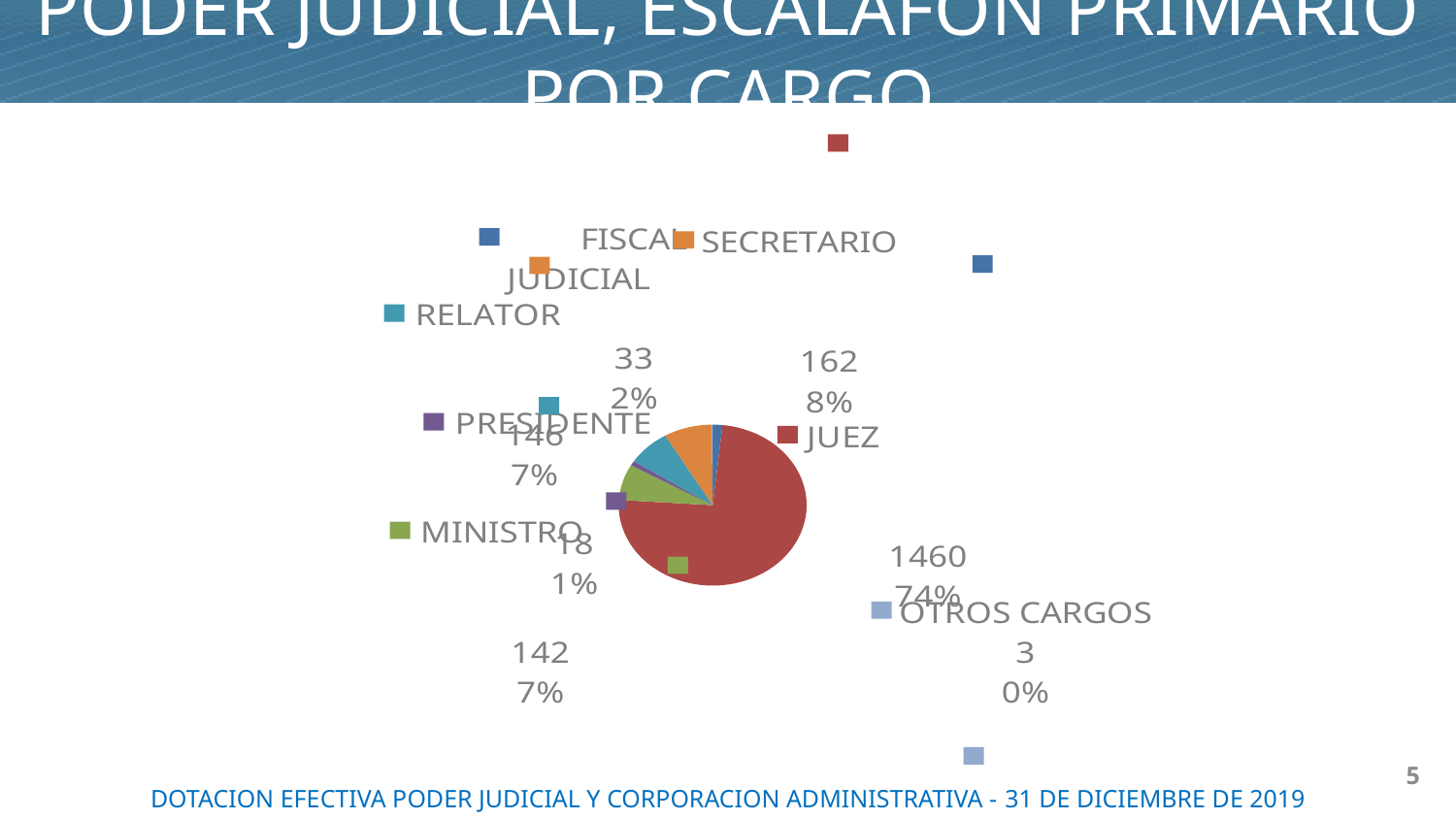
What percentage is shown for the smallest slice of the pie chart? 0% What is the difference between the largest value (1460) and the smallest value (3) shown on the pie chart? 1457 How many slices of the pie chart are labelled with 7%? 2 Which category has the largest slice in the pie chart? JUEZ What is the smallest value printed on the pie chart? 3 What is the title of the slide containing the pie chart? PODER JUDICIAL, ESCALAFON PRIMARIO POR CARGO What share of the pie does JUEZ represent? 74% What kind of chart is shown on the slide? pie chart What colour is the JUEZ slice in the pie chart? red What is the value shown for JUEZ in the pie chart? 1460 Which is larger, the value for JUEZ or the value for OTROS CARGOS? JUEZ How many categories does the legend of the pie chart list? 7